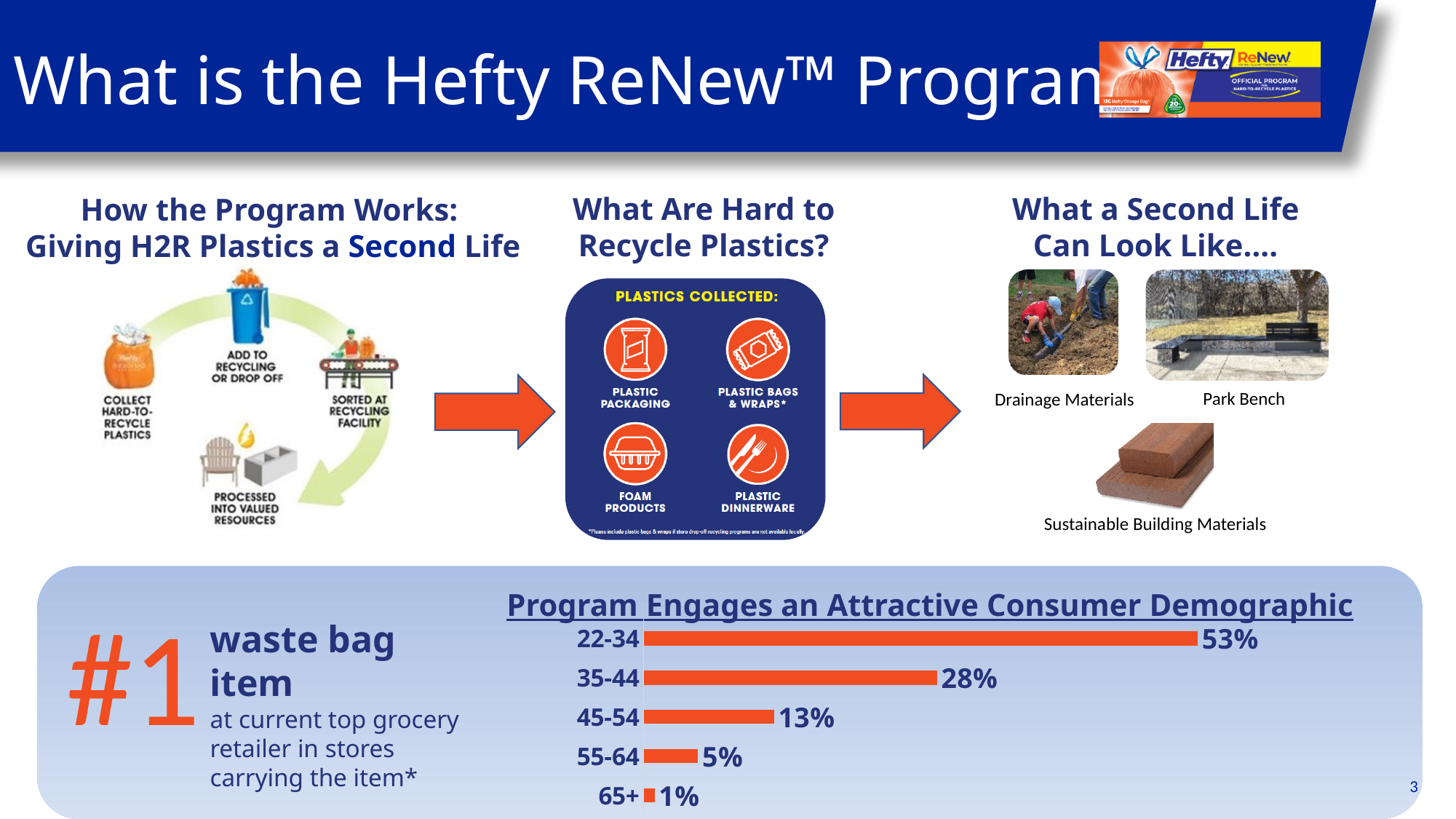
What is the difference between the values for 22-34 and 35-44? 25% What is the value for the 35-44 age group? 28% What is the value for the 65+ age group? 1% What is the value for the 22-34 age group? 53% Which age group has the lowest value? 65+ Which is larger, the value for 45-54 or the value for 55-64? 45-54 What is the value for the 45-54 age group? 13% Which age group has the highest value? 22-34 What kind of chart is shown on the slide? Bar chart What is the title of the chart? Program Engages an Attractive Consumer Demographic How many age groups are shown in the chart? 5 What is the value for the 55-64 age group? 5%